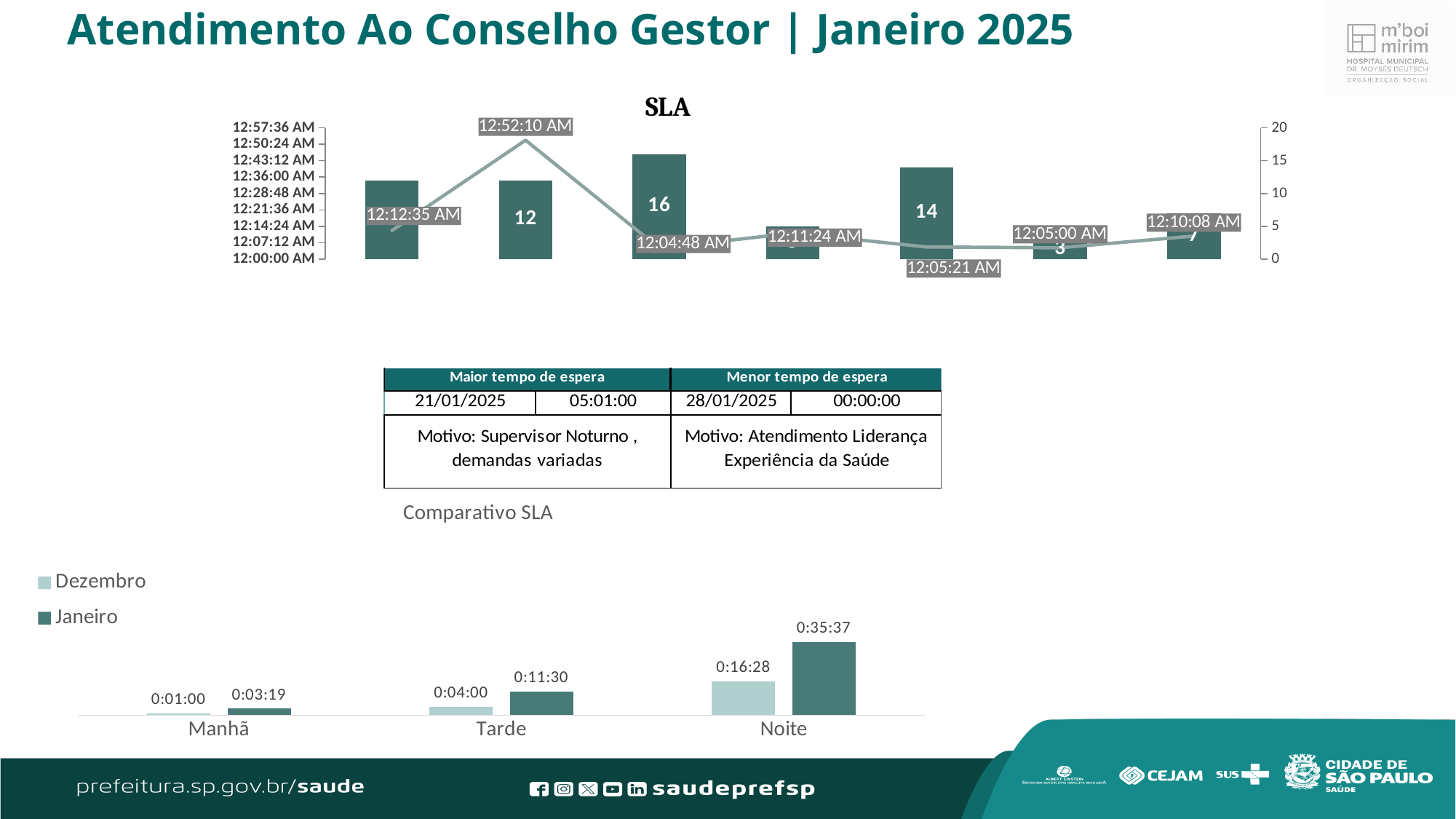
In the top chart titled SLA, what is the highest value labelled on a bar? 16 In the bottom chart (Comparativo SLA), which is larger for Tarde: the Dezembro value or the Janeiro value? Janeiro In the bottom chart (Comparativo SLA), what is the Dezembro value for Tarde? 0:04:00 In the bottom chart (Comparativo SLA), what is the Janeiro value for Noite? 0:35:37 In the bottom chart (Comparativo SLA), which category has the lowest Dezembro value? Manhã In the bottom chart (Comparativo SLA), how many categories are shown on the x axis? 3 What kind of chart is the bottom chart (Comparativo SLA)? Bar chart In the bottom chart (Comparativo SLA), what is the Janeiro value for Manhã? 0:03:19 In the bottom chart (Comparativo SLA), which category has the highest Janeiro value? Noite In the bottom chart (Comparativo SLA), what is the Dezembro value for Noite? 0:16:28 In the bottom chart (Comparativo SLA), how many series does the legend list? 2 In the top chart titled SLA, what is the highest value labelled on the line? 12:52:10 AM